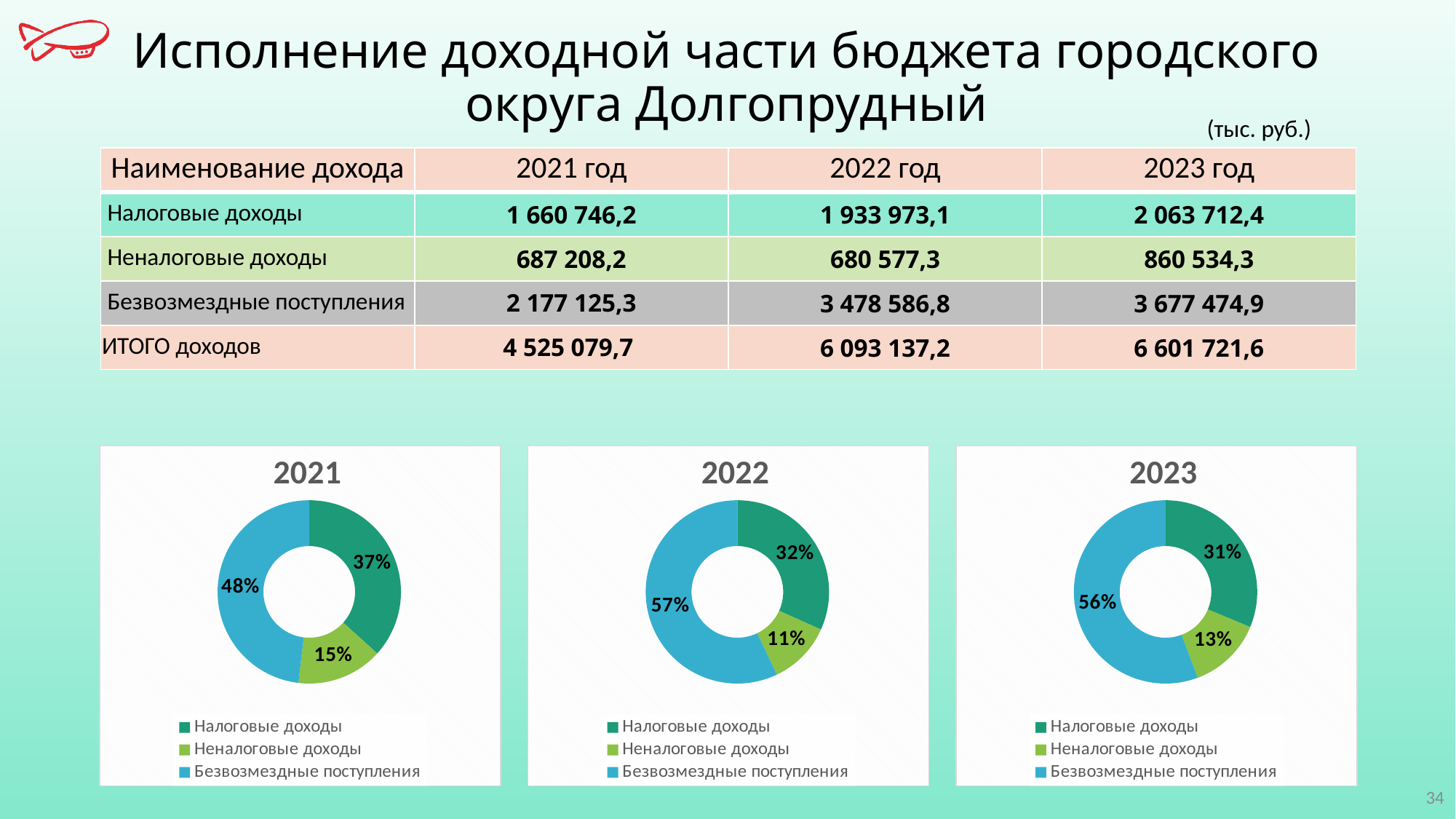
How many slices does the 2022 chart have? 3 How many charts are shown on the slide? 3 In the 2022 chart, what is the difference between the shares of Налоговые доходы and Неналоговые доходы? 21% In the 2021 chart, which is larger: the share of Налоговые доходы or the share of Неналоговые доходы? Налоговые доходы What type of chart is the 2021 chart? doughnut chart In the 2021 chart, what share do Налоговые доходы have? 37% How many entries does the legend of the 2023 chart list? 3 In the 2021 chart, which category has the largest share? Безвозмездные поступления In the 2022 chart, which category has the smallest share? Неналоговые доходы In the 2022 chart, what share do Безвозмездные поступления have? 57% In the 2023 chart, what is the difference between the shares of Безвозмездные поступления and Налоговые доходы? 25% In the 2023 chart, what share do Неналоговые доходы have? 13%